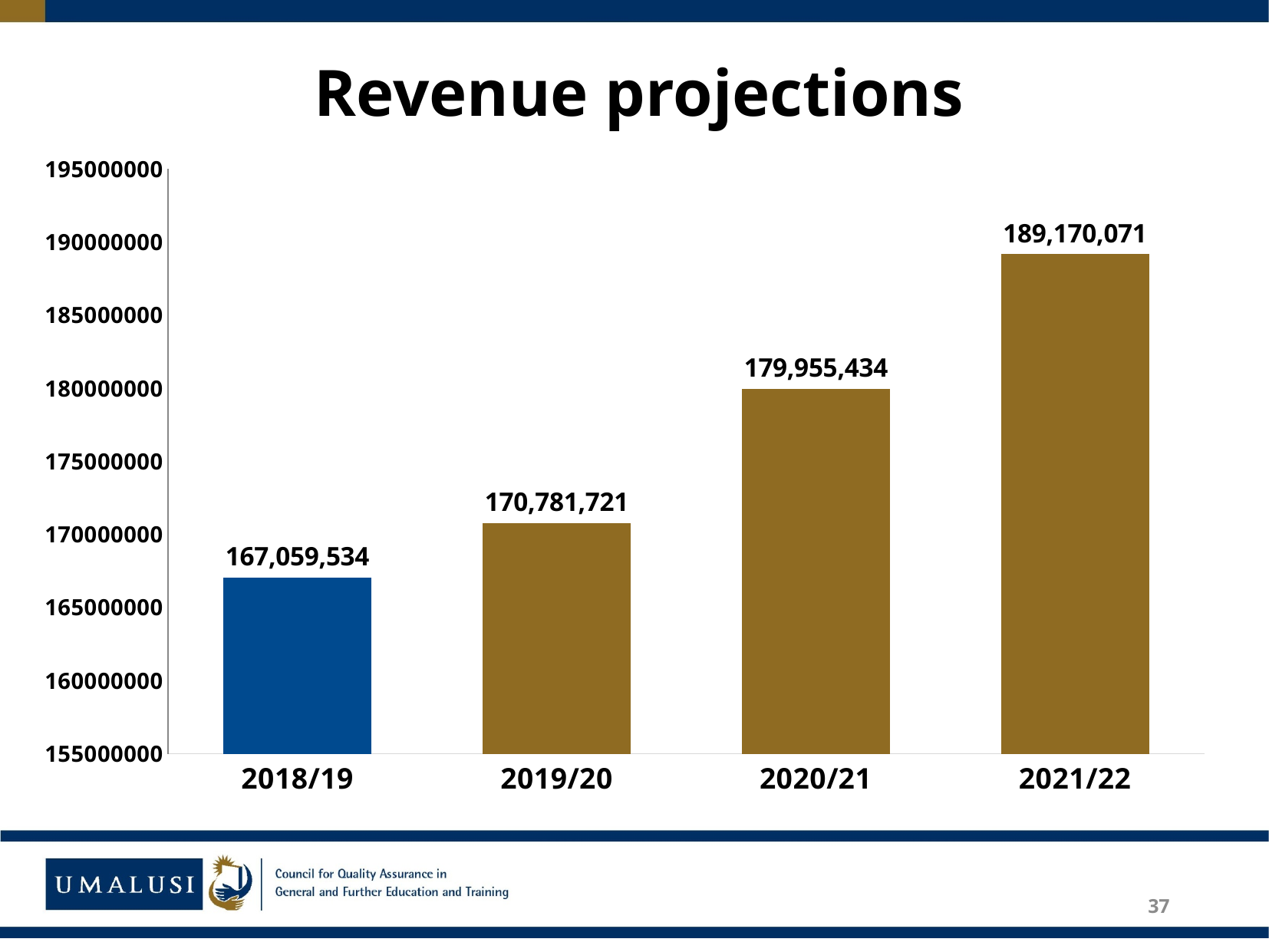
Which is larger, the revenue projection for 2019/20 or for 2020/21? 2020/21 What kind of chart is shown on the slide? bar chart What is the revenue projection for 2021/22? 189,170,071 What is the difference between the revenue projections for 2020/21 and 2019/20? 9,173,713 Do the revenue projections rise or fall from 2018/19 to 2021/22? rise What is the revenue projection for 2020/21? 179,955,434 What is the revenue projection for 2018/19? 167,059,534 Which year has the lowest revenue projection? 2018/19 What is the difference between the revenue projections for 2021/22 and 2018/19? 22,110,537 Is the revenue projection for 2019/20 greater or less than 175000000? less Which year has the highest revenue projection? 2021/22 How many years are shown on the chart? 4